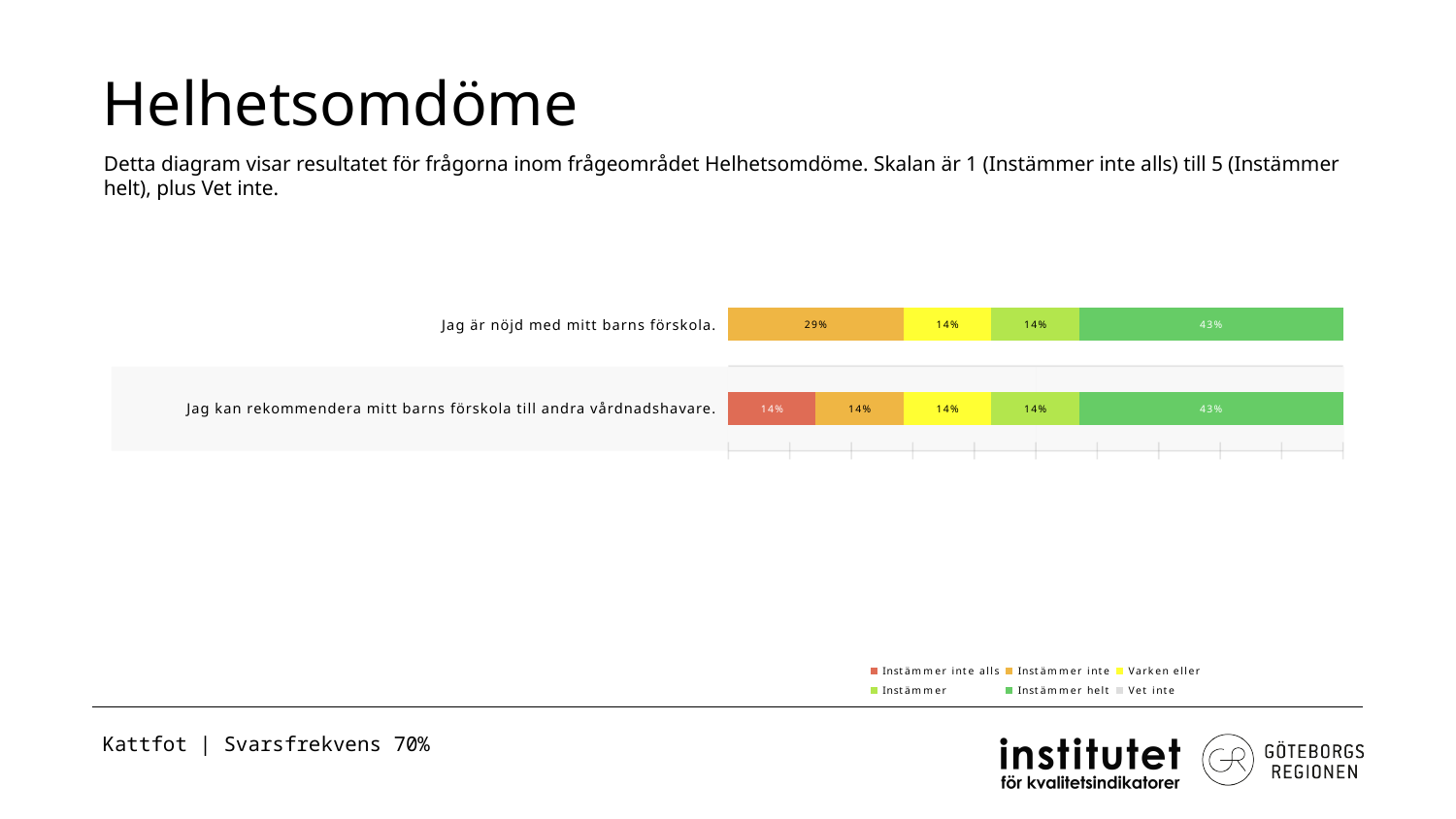
Which is larger for "Jag kan rekommendera mitt barns förskola till andra vårdnadshavare.": "Instämmer helt" or "Instämmer inte alls"? Instämmer helt How many categories (statements) are plotted in the chart? 2 What is the difference between "Instämmer helt" and "Instämmer inte" for "Jag är nöjd med mitt barns förskola."? 14% What is the title of the slide containing the chart? Helhetsomdöme How many series does the legend list? 6 What is the value of "Instämmer inte" for "Jag är nöjd med mitt barns förskola."? 29% What is the total of the labelled segments for "Jag kan rekommendera mitt barns förskola till andra vårdnadshavare."? 99% What is the value of "Instämmer helt" for "Jag är nöjd med mitt barns förskola."? 43% What kind of chart is shown on the slide? stacked bar chart What is the value of "Instämmer inte alls" for "Jag kan rekommendera mitt barns förskola till andra vårdnadshavare."? 14% Which response category has the largest share for "Jag är nöjd med mitt barns förskola."? Instämmer helt What is the value of "Varken eller" for "Jag kan rekommendera mitt barns förskola till andra vårdnadshavare."? 14%